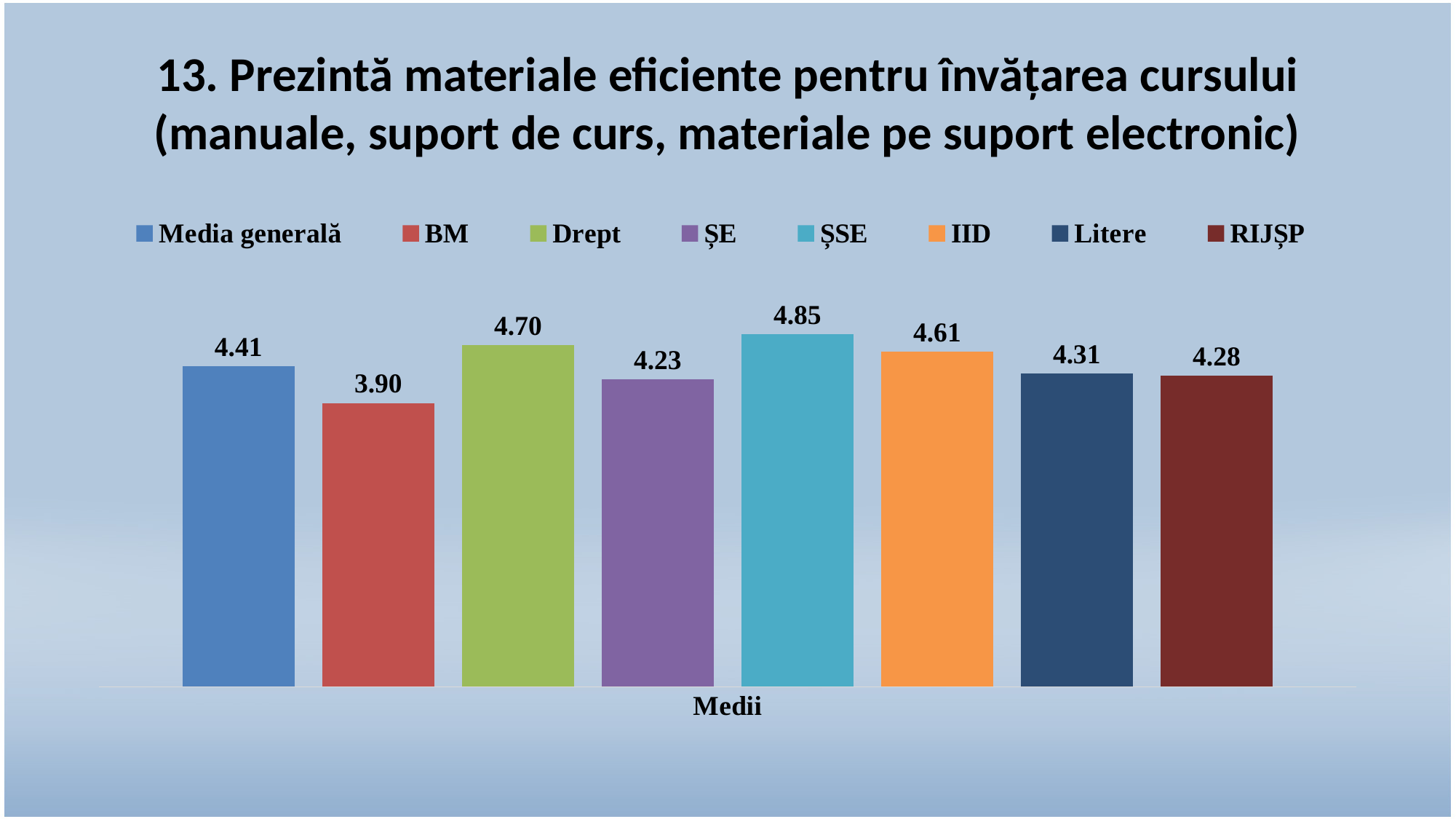
What is the value for Litere? 4.31 Which is larger, the value for Drept or the value for IID? Drept What is the value for Media generală? 4.41 How many series does the legend list? 8 Which series has the highest value? ȘSE What kind of chart is shown on the slide? Bar chart What is the difference between the values for ȘSE and BM? 0.95 What is the value for BM? 3.90 What is the value for Drept? 4.70 What is the difference between the values for IID and ȘE? 0.38 Which series has the lowest value? BM What is the label shown on the x axis of the chart? Medii